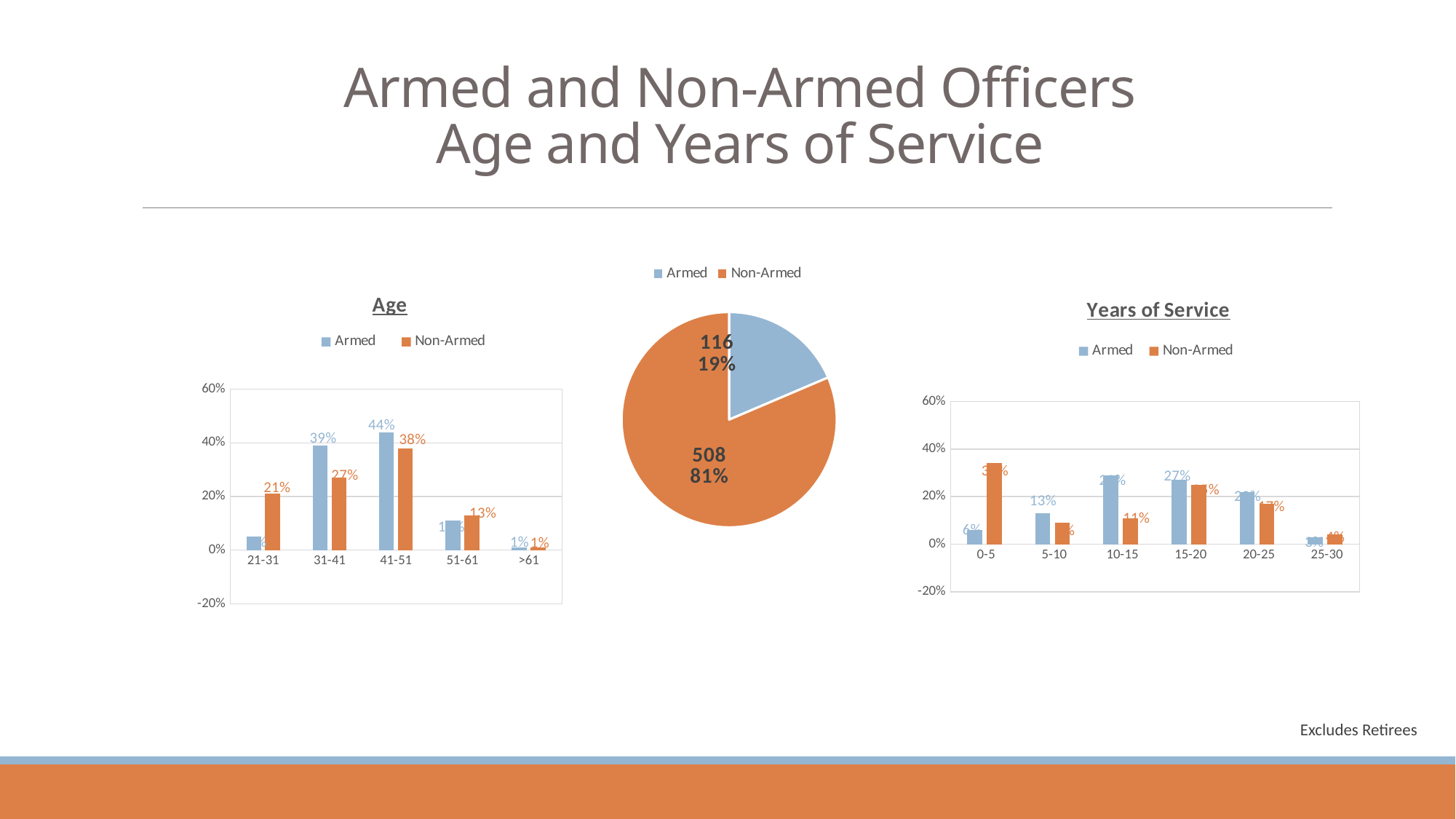
In the Age chart, which age group has the highest Non-Armed value? 41-51 In the Age chart, what is the difference between the Armed and Non-Armed values for the 41-51 age group? 6% In the pie chart, how many Armed officers are there? 116 In the Age chart, what is the Non-Armed value for the 21-31 age group? 21% In the Age chart, what is the Armed value for the 31-41 age group? 39% In the pie chart, what is the share of Non-Armed officers? 81% In the Years of Service chart, what is the Armed value for 15-20 years? 27% In the Years of Service chart, what is the Non-Armed value for 20-25 years? 17% In the Age chart, how many age groups are shown on the x axis? 5 In the Age chart, what is the Armed value for the 41-51 age group? 44% In the Years of Service chart, how many series does the legend list? 2 In the Years of Service chart, is the Non-Armed value for 0-5 years greater or less than 20%? greater